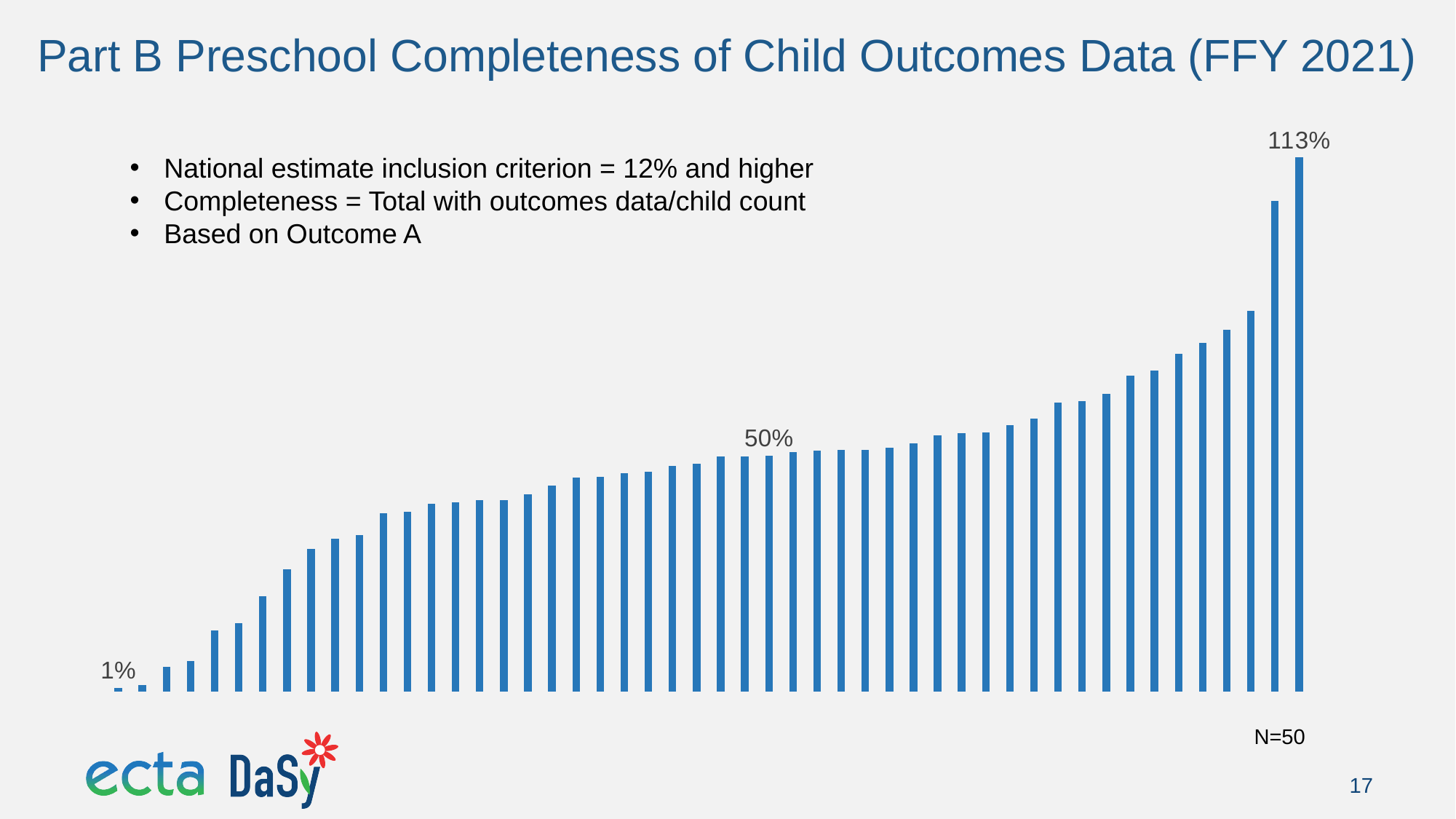
According to the slide, what is the national estimate inclusion criterion? 12% and higher What kind of chart is shown on the slide? Bar chart What is the highest value shown in the chart? 113% What is the difference between the highest labeled value (113%) and the lowest labeled value (1%)? 112 percentage points What value is labeled on the bar in the middle of the chart? 50% Is the highest bar's value greater or less than 100%? greater What is the lowest value shown in the chart? 1% What is the title of the slide containing the chart? Part B Preschool Completeness of Child Outcomes Data (FFY 2021) How many states (N) are represented in the chart? 50 Do the bar values rise or fall from left to right across the chart? Rise